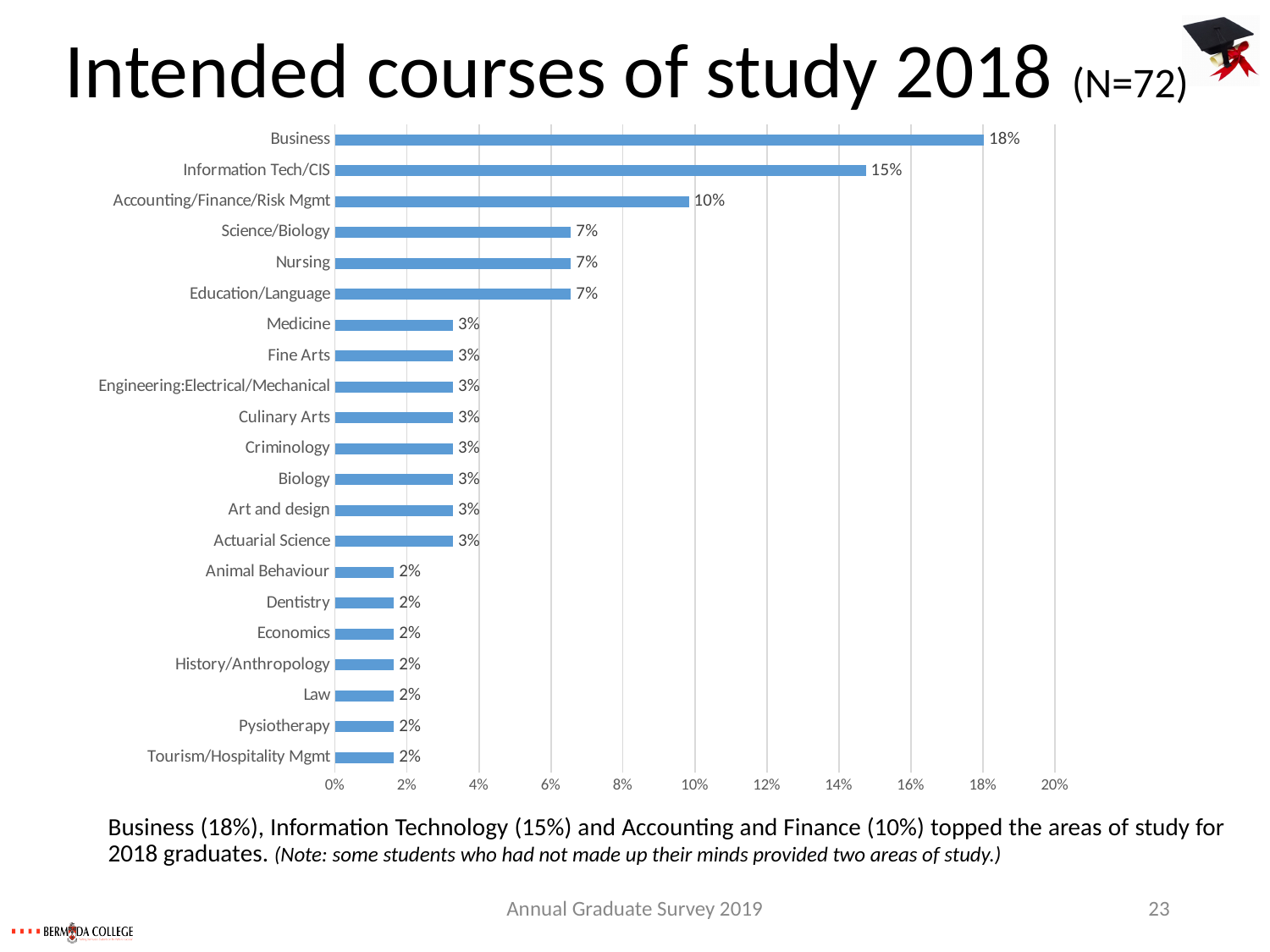
What is the value for Accounting/Finance/Risk Mgmt? 10% What is the value for Information Tech/CIS? 15% How many categories are shown in the chart? 21 Which category has the highest value? Business What is the difference between the values for Accounting/Finance/Risk Mgmt and Science/Biology? 3% What is the value for Medicine? 3% What is the difference between the values for Business and Information Tech/CIS? 3% What is the value for Business? 18% What is the value for Law? 2% What is the value for Nursing? 7% What kind of chart is shown on the slide? Bar chart Which is larger, the value for Information Tech/CIS or the value for Accounting/Finance/Risk Mgmt? Information Tech/CIS